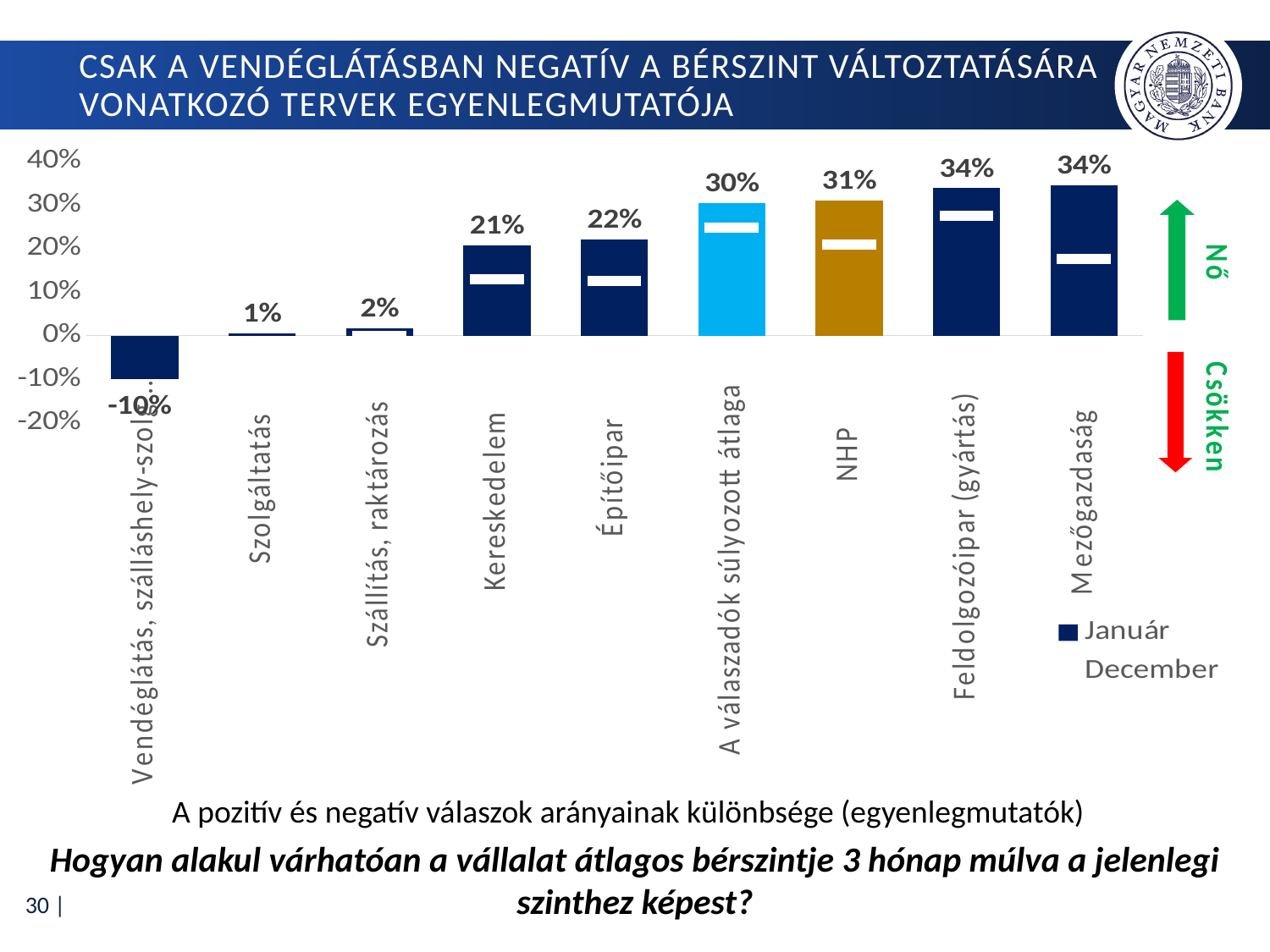
What is the difference between the January values for Feldolgozóipar (gyártás) and Kereskedelem? 13 percentage points How many categories are shown on the x axis? 9 What is the January value for Építőipar? 22% What is the January value for A válaszadók súlyozott átlaga? 30% Which series is shown as white markers inside the bars? December What is the January value for Kereskedelem? 21% What kind of chart is shown on the slide? bar chart Is the December value for Mezőgazdaság greater or less than 20%? less How many series does the legend list? 2 What is the January value for NHP? 31% Which category has the lowest January value? Vendéglátás, szálláshely-szolgáltatás Which has a higher January value, NHP or Építőipar? NHP